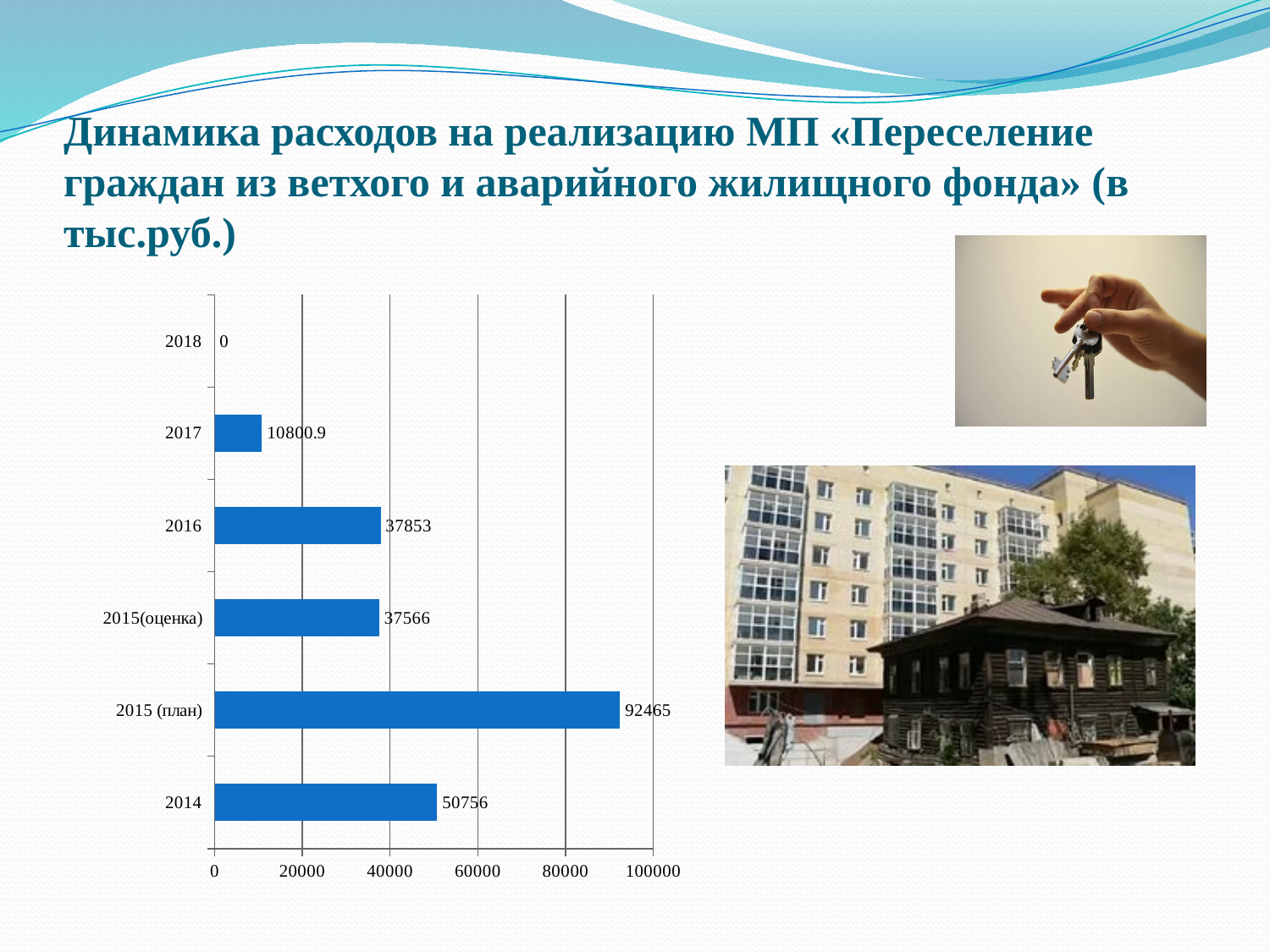
Which is larger, the value for 2014 or the value for 2016? 2014 What is the value for 2017? 10800.9 What is the value for 2015 (план)? 92465 How many categories are shown on the chart? 6 What is the difference between the values for 2016 and 2015(оценка)? 287 Which category has the highest value? 2015 (план) What is the value for 2014? 50756 What kind of chart is shown on the slide? bar chart Which category has the lowest value? 2018 Is the value for 2015 (план) greater or less than 80000? greater What is the value for 2018? 0 What is the difference between the values for 2015 (план) and 2015(оценка)? 54899